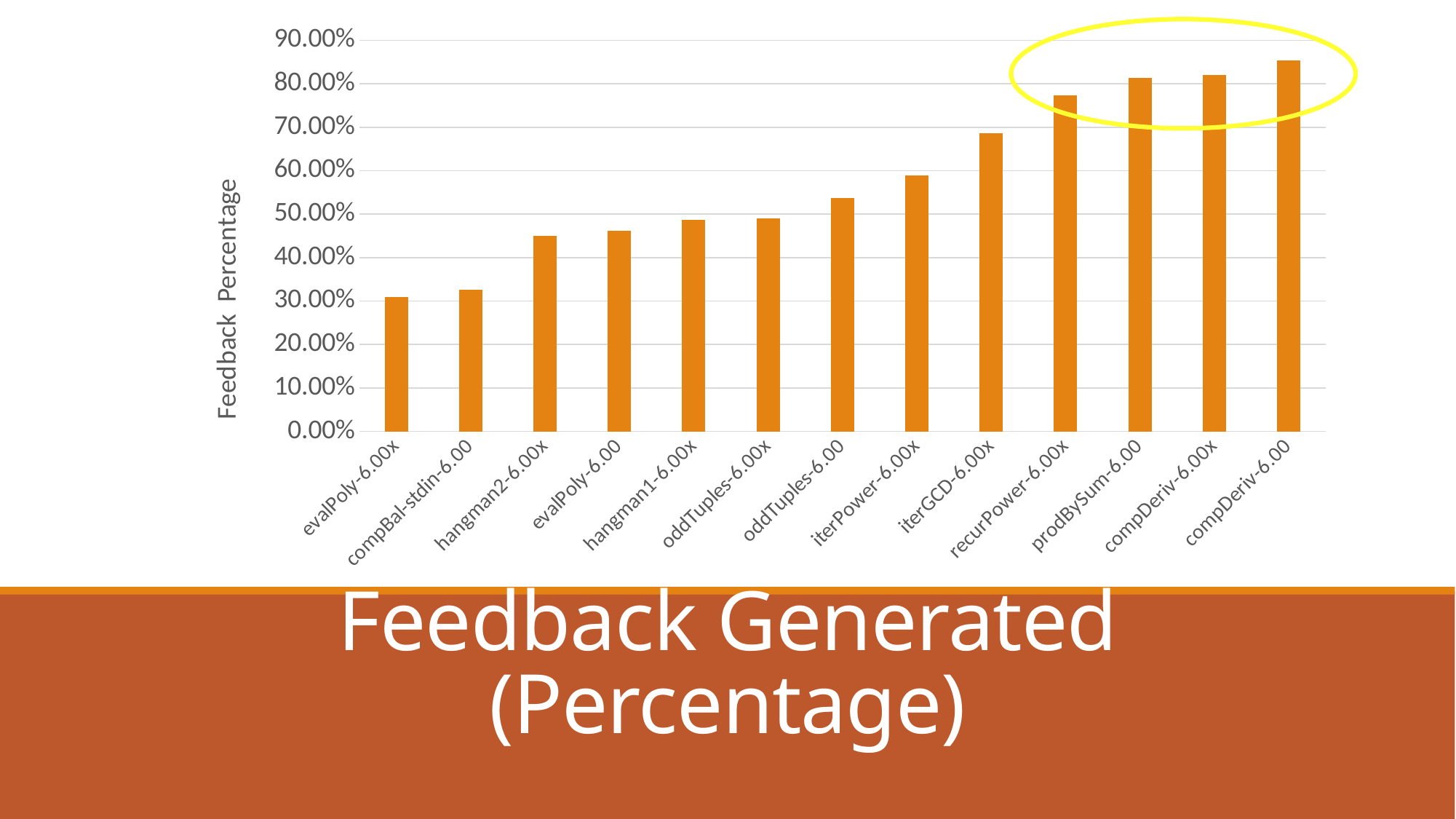
Do the values generally rise or fall moving left to right along the x axis? rise Which has the larger value, iterGCD-6.00x or oddTuples-6.00? iterGCD-6.00x Is the value for compDeriv-6.00 greater or less than 80.00%? greater Is the value for iterGCD-6.00x greater or less than 60.00%? greater What kind of chart is shown on the slide? bar chart Is the value for evalPoly-6.00x greater or less than 40.00%? less Which category has the highest feedback percentage? compDeriv-6.00 Which category has the lowest feedback percentage? evalPoly-6.00x How many categories are plotted along the x axis? 13 What is the label on the vertical axis? Feedback Percentage